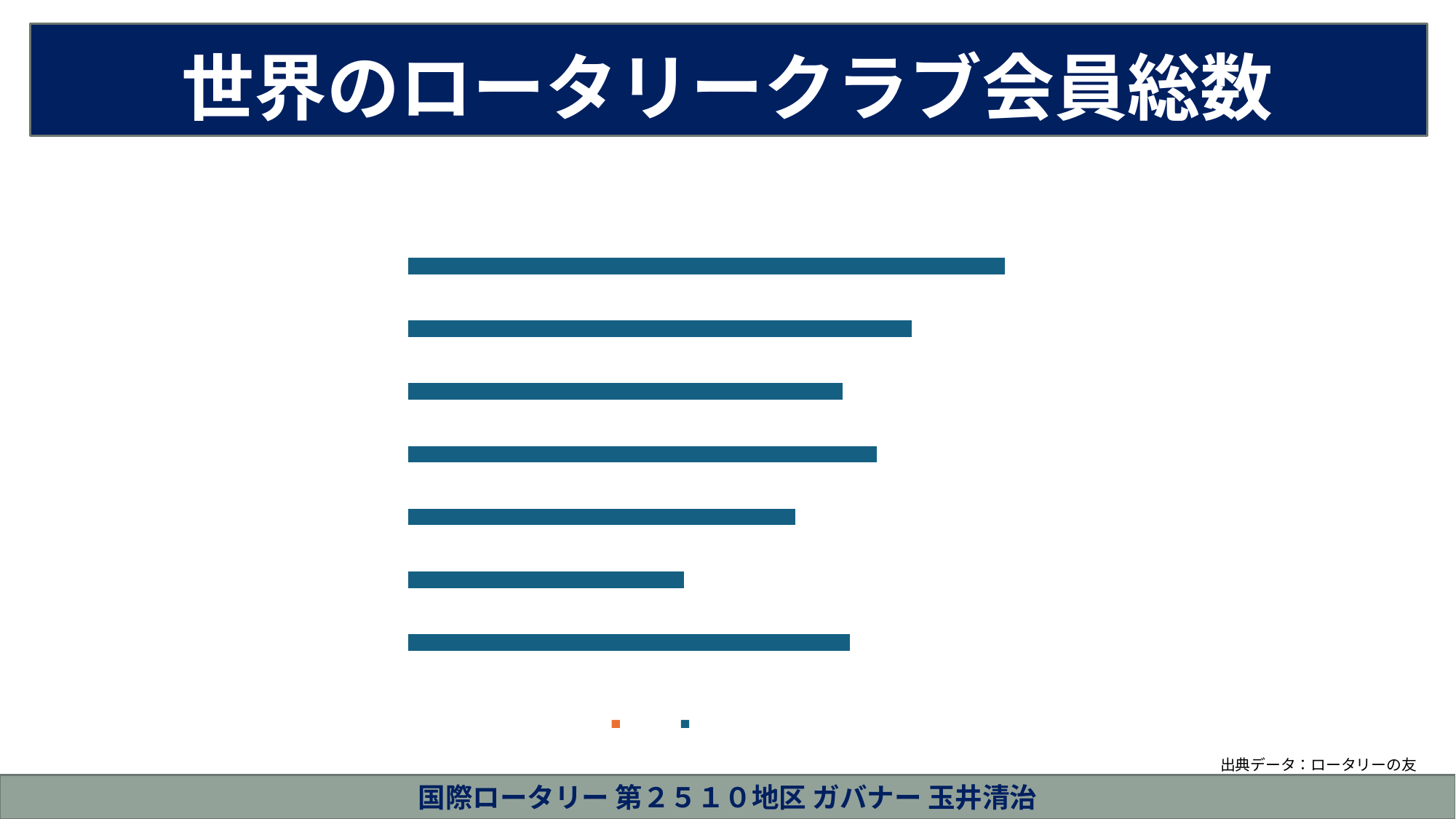
What colour are the bars in the chart? dark blue How many bars are plotted in the chart? 7 Which bar is the shortest in the chart, counting from the top? the sixth bar Which bar is the longest in the chart, counting from the top? the first (top) bar Which is longer, the sixth bar from the top or the seventh (bottom) bar? the seventh bar Are the bars in the chart oriented horizontally or vertically? horizontally Which is longer, the first bar from the top or the second bar from the top? the first bar Which is longer, the fifth bar from the top or the sixth bar from the top? the fifth bar What kind of chart is shown on the slide? bar chart